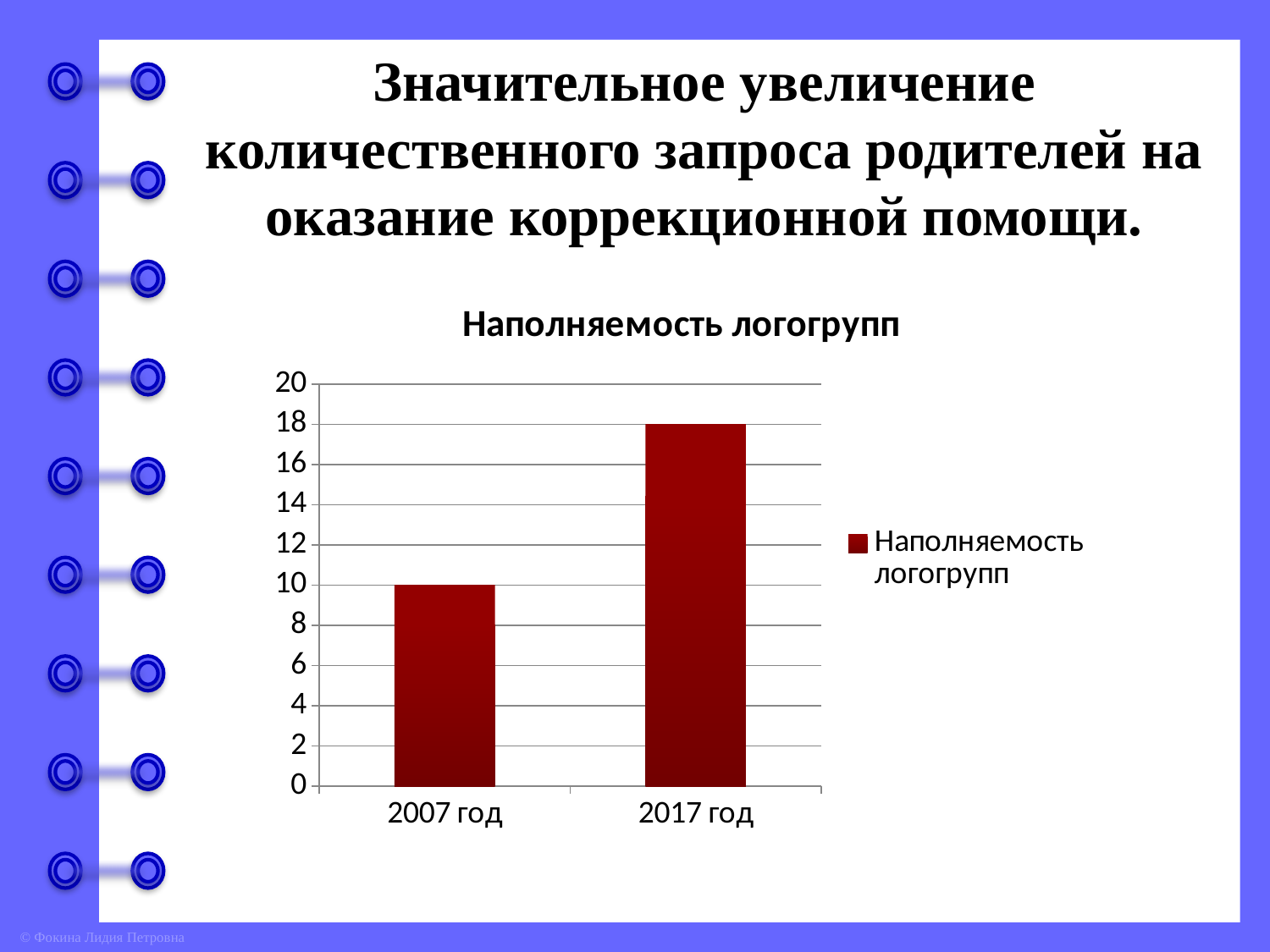
What is the value for 2007 год in the chart? 10 Is the value for 2007 год greater or less than 12? less Which is larger, the value for 2007 год or the value for 2017 год? 2017 год What is the title of the chart? Наполняемость логогрупп What kind of chart is shown on the slide? bar chart Which category has the lowest value? 2007 год How many series does the legend list? 1 What is the value for 2017 год in the chart? 18 Which category has the highest value? 2017 год What is the difference between the values for 2017 год and 2007 год? 8 Is the value for 2017 год greater or less than 16? greater How many categories are shown on the x axis? 2